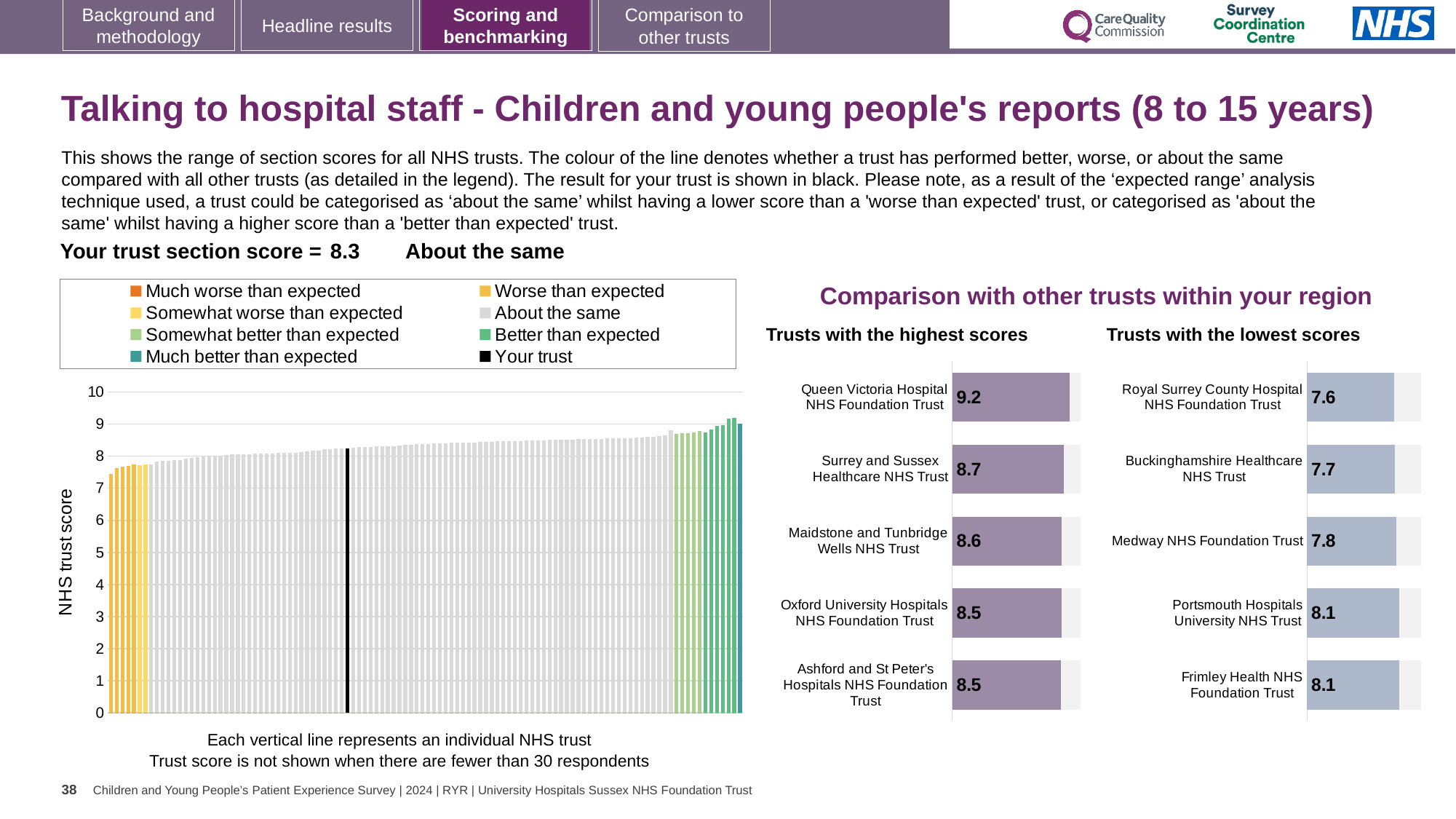
What kind of chart is the NHS trust score chart on the left of the slide? Bar chart In the 'Trusts with the lowest scores' chart, which trust has the lowest score? Royal Surrey County Hospital NHS Foundation Trust In the 'Trusts with the lowest scores' chart, what is the score for Medway NHS Foundation Trust? 7.8 In the NHS trust score chart on the left, do the bar values rise or fall from left to right? Rise In the 'Trusts with the highest scores' chart, which trust has the highest score? Queen Victoria Hospital NHS Foundation Trust How many trusts are shown in the 'Trusts with the lowest scores' chart? 5 In the NHS trust score chart on the left, is the value of the black 'Your trust' bar greater or less than 8? greater In the 'Trusts with the lowest scores' chart, which has the larger score: Buckinghamshire Healthcare NHS Trust or Medway NHS Foundation Trust? Medway NHS Foundation Trust In the 'Trusts with the highest scores' chart, what is the score for Maidstone and Tunbridge Wells NHS Trust? 8.6 How many entries does the legend of the NHS trust score chart on the left list? 8 In the 'Trusts with the highest scores' chart, what is the score for Queen Victoria Hospital NHS Foundation Trust? 9.2 In the 'Trusts with the highest scores' chart, what is the difference between the scores of Queen Victoria Hospital NHS Foundation Trust and Surrey and Sussex Healthcare NHS Trust? 0.5